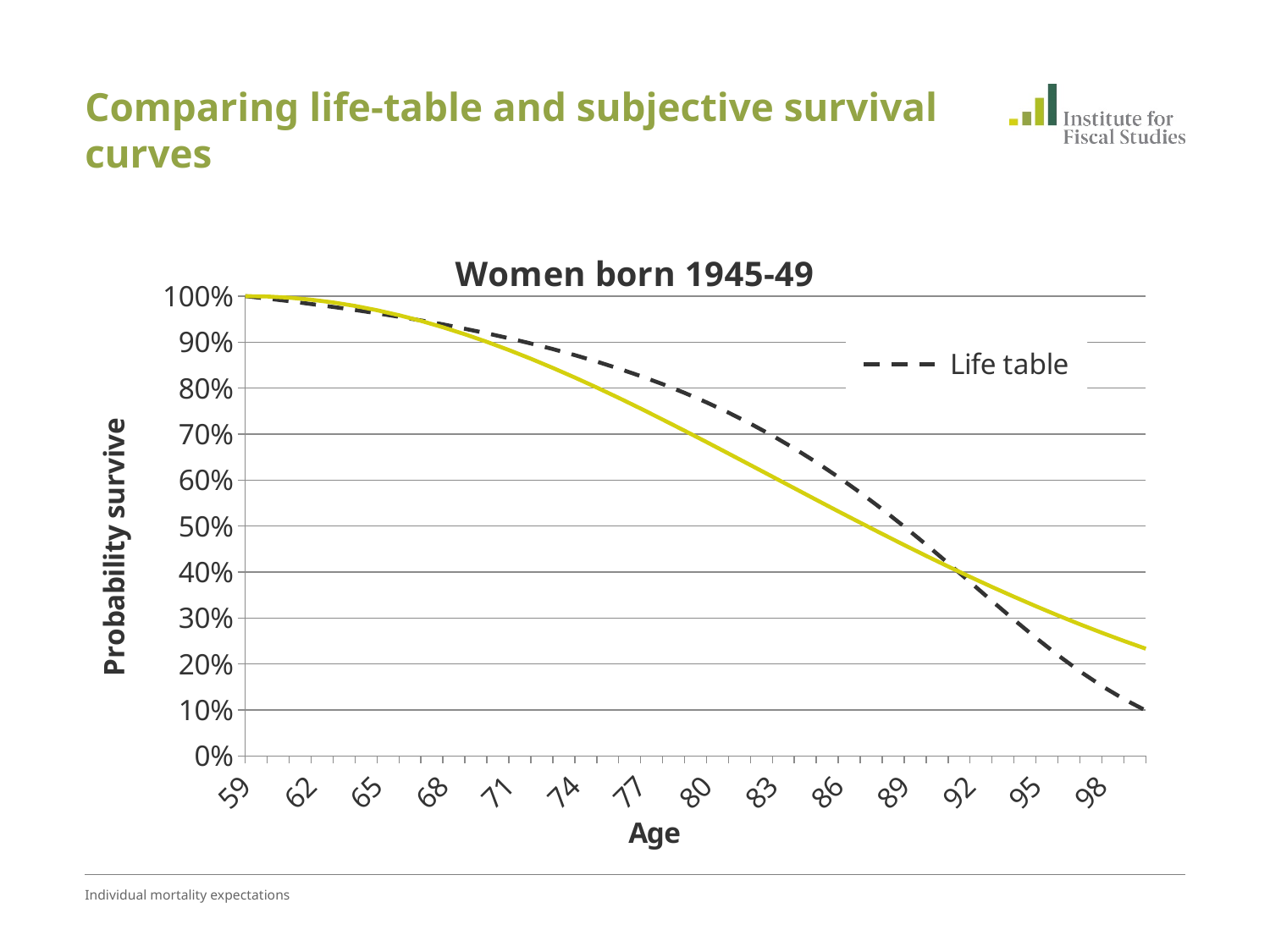
How many series does the legend list? 1 At age 98, which line is higher: the Life table line or the solid yellow-green line? the solid yellow-green line What kind of chart is shown on the slide? line chart Is the value of the Life table line at age 98 greater or less than 20%? less What is the title of the chart? Women born 1945-49 What series name does the chart's legend list? Life table At age 80, which line is higher: the Life table line or the solid yellow-green line? Life table Do the plotted values rise or fall as age increases along the x axis? fall How many lines are plotted on the chart? 2 What is the value of the Life table line at age 59? 100% Is the value of the Life table line at age 68 greater or less than 90%? greater Is the value of the solid yellow-green line at age 98 greater or less than 20%? greater